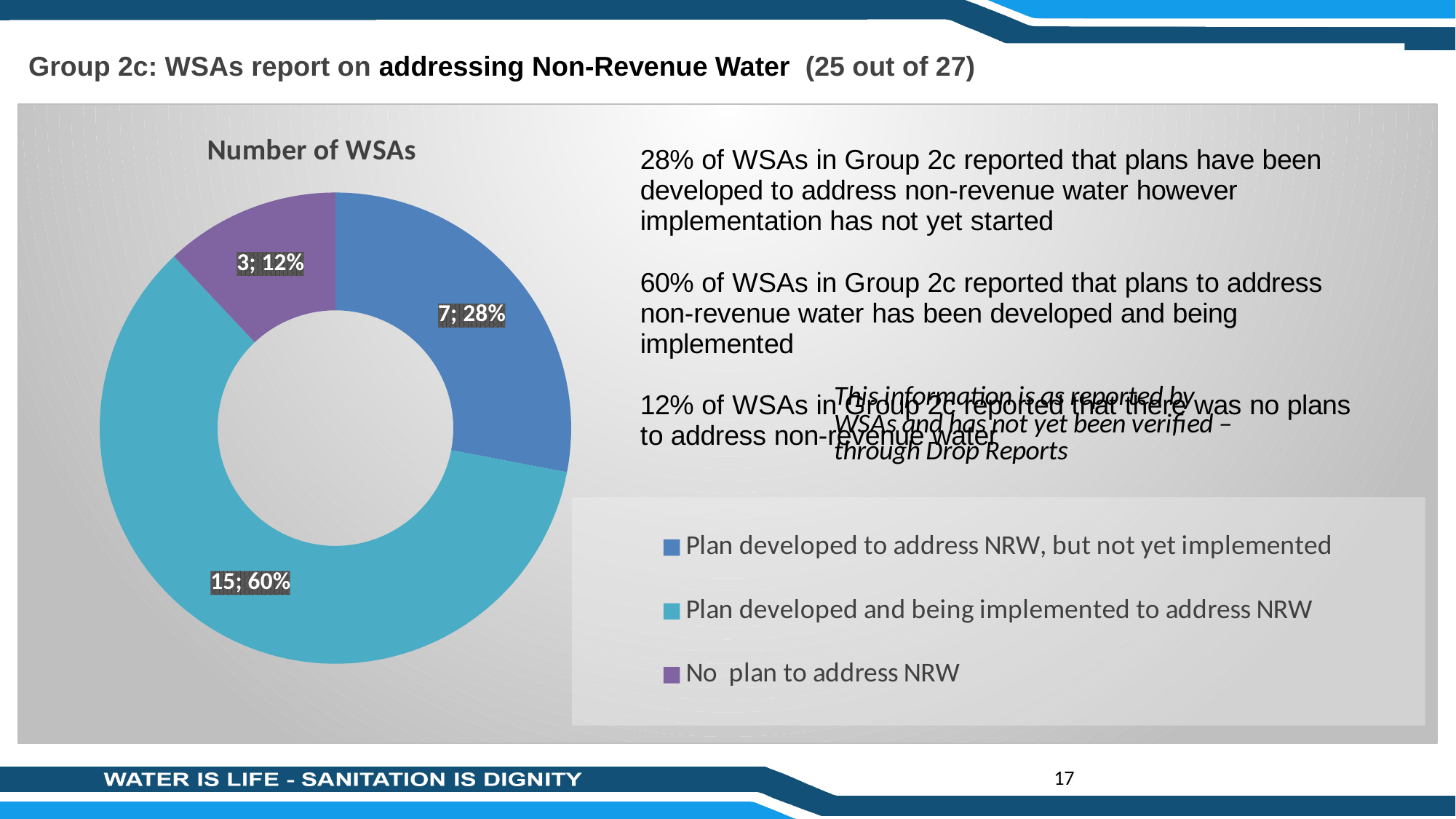
How many WSAs reported no plan to address NRW? 3 How many WSAs reported a plan developed and being implemented to address NRW? 15 What is the title of the chart? Number of WSAs What is the difference in number of WSAs between 'Plan developed and being implemented to address NRW' and 'Plan developed to address NRW, but not yet implemented'? 8 What share of the chart is 'Plan developed and being implemented to address NRW'? 60% How many categories does the chart show? 3 What share of the chart is 'No plan to address NRW'? 12% Which category has the smallest slice? No plan to address NRW What is the total number of WSAs across all slices? 25 Which category has the largest slice? Plan developed and being implemented to address NRW How many WSAs reported a plan developed to address NRW, but not yet implemented? 7 What type of chart is shown on the slide? Doughnut (pie) chart